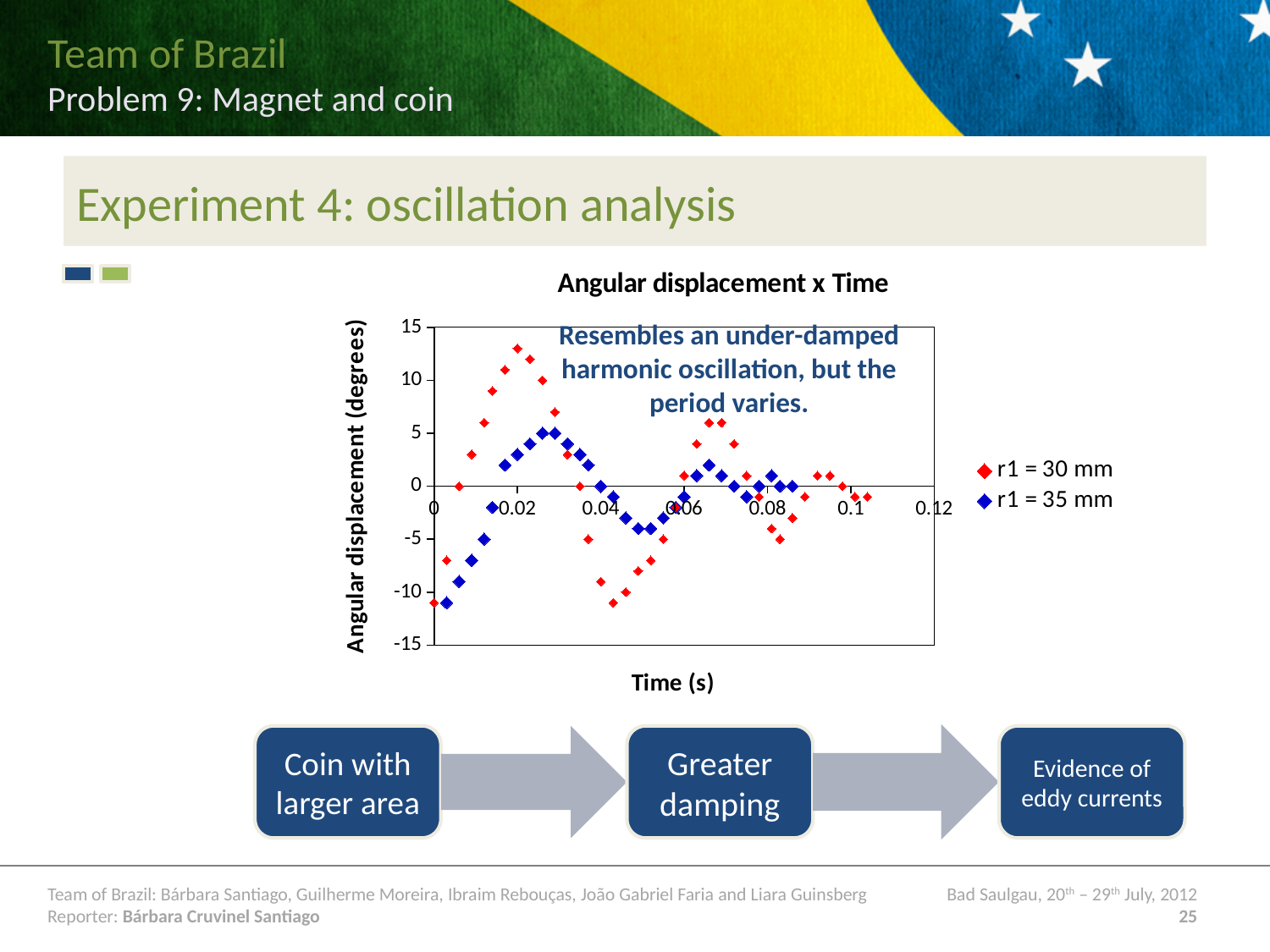
What is the largest value shown on the x axis of the chart? 0.12 What is the title of the chart? Angular displacement x Time How many series does the legend of the chart list? 2 What kind of chart is shown on the slide? Scatter chart What is the label of the y axis of the chart? Angular displacement (degrees) Which series shows the smaller oscillation amplitude after the first peak, r1 = 30 mm or r1 = 35 mm? r1 = 35 mm Which series reaches the higher peak angular displacement, r1 = 30 mm or r1 = 35 mm? r1 = 30 mm Is the lowest angular displacement of the r1 = 30 mm series greater or less than -10 degrees? less Does the amplitude of the oscillations increase or decrease as time increases along the x axis? decrease Is the highest angular displacement reached by the r1 = 35 mm series greater or less than 10 degrees? less What are the two series named in the chart legend? r1 = 30 mm and r1 = 35 mm Is the highest angular displacement reached by the r1 = 30 mm series greater or less than 10 degrees? greater